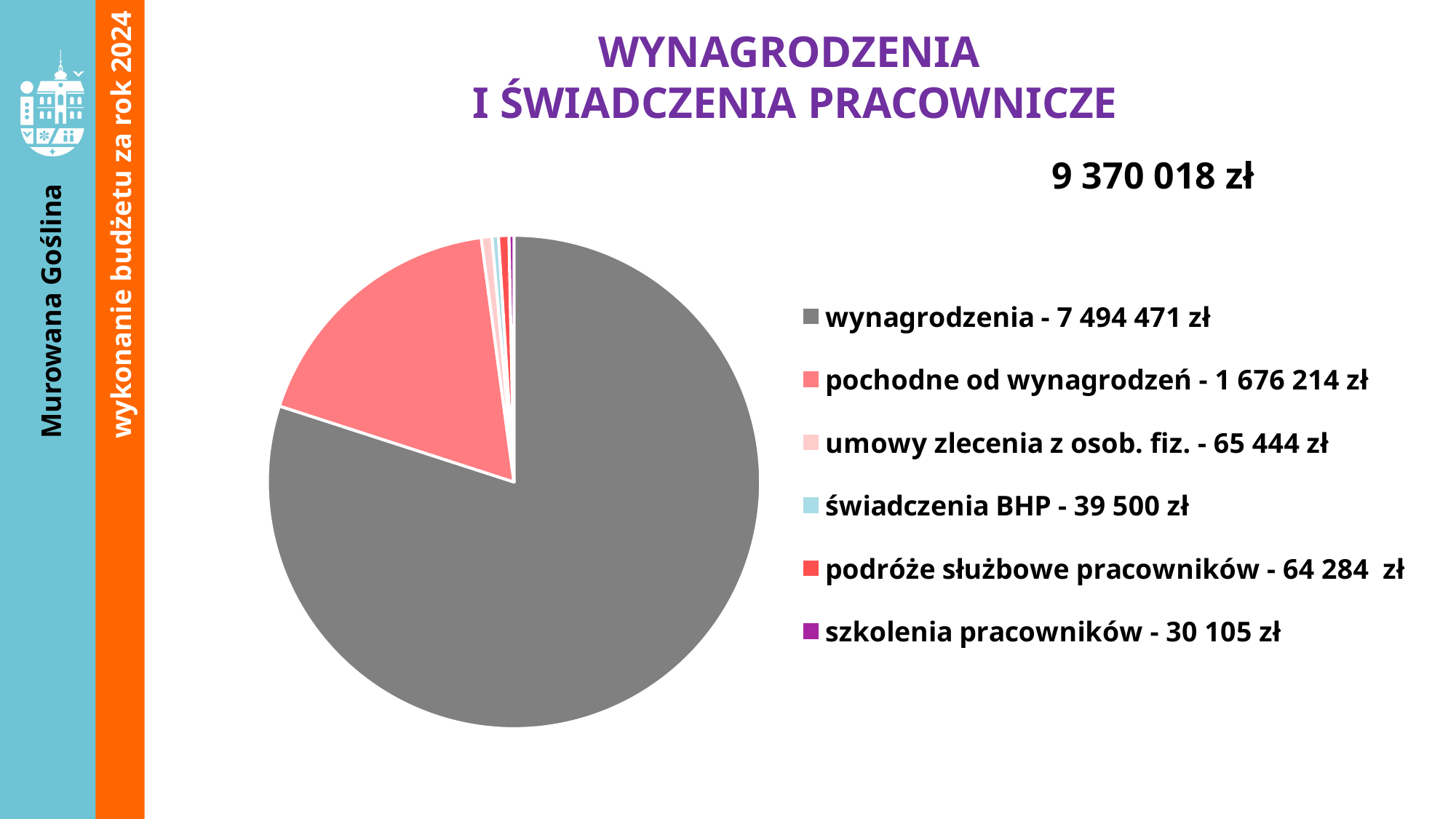
How many categories does the pie chart show? 6 Which category has the lowest value? szkolenia pracowników What is the value for świadczenia BHP? 39 500 zł What is the total amount shown for all categories? 9 370 018 zł What kind of chart is shown on the slide? pie chart What is the value for pochodne od wynagrodzeń? 1 676 214 zł What is the difference between świadczenia BHP and szkolenia pracowników? 9 395 zł Which is larger: umowy zlecenia z osob. fiz. or podróże służbowe pracowników? umowy zlecenia z osob. fiz. What is the difference between wynagrodzenia and pochodne od wynagrodzeń? 5 818 257 zł What is the value for szkolenia pracowników? 30 105 zł What is the value for wynagrodzenia? 7 494 471 zł Which category has the highest value? wynagrodzenia